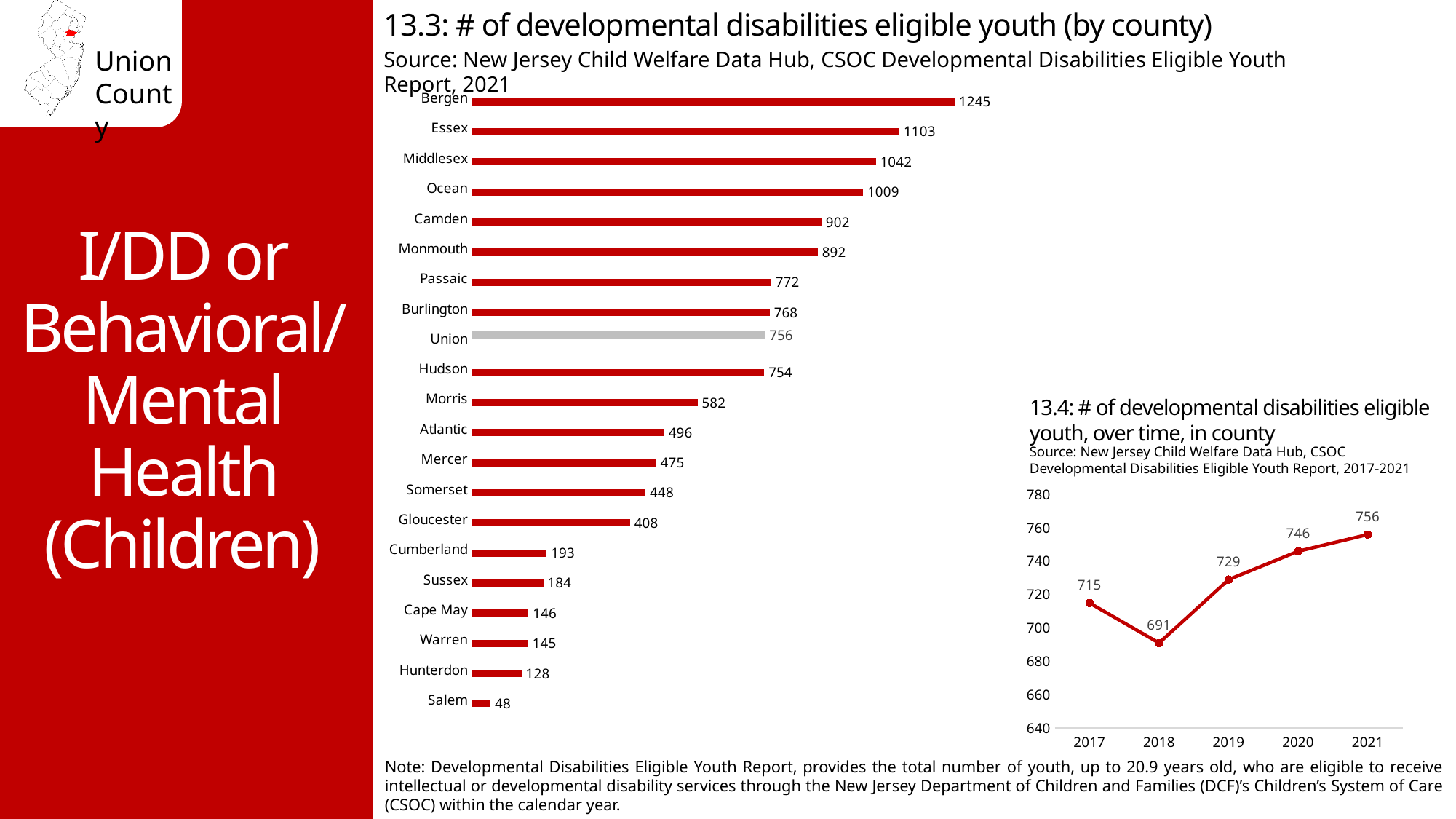
In chart 13.3 (by county), how many counties are shown? 21 In chart 13.4 (over time, in county), which year has the lowest value? 2018 In chart 13.3 (by county), which has a larger value, Camden or Monmouth? Camden In chart 13.3 (by county), what is the difference between the values for Bergen and Essex? 142 In chart 13.3 (by county), which county has the lowest number of developmental disabilities eligible youth? Salem In chart 13.4 (over time, in county), what is the value for 2018? 691 In chart 13.4 (over time, in county), what is the difference between the 2021 and 2017 values? 41 In chart 13.3 (by county), what is the value for Gloucester? 408 What kind of chart is chart 13.3 (# of developmental disabilities eligible youth by county)? Bar chart In chart 13.3 (# of developmental disabilities eligible youth by county), what is the value for Union? 756 In chart 13.4 (over time, in county), do the values rise or fall from 2018 to 2021? Rise In chart 13.3 (by county), which county has the highest number of developmental disabilities eligible youth? Bergen